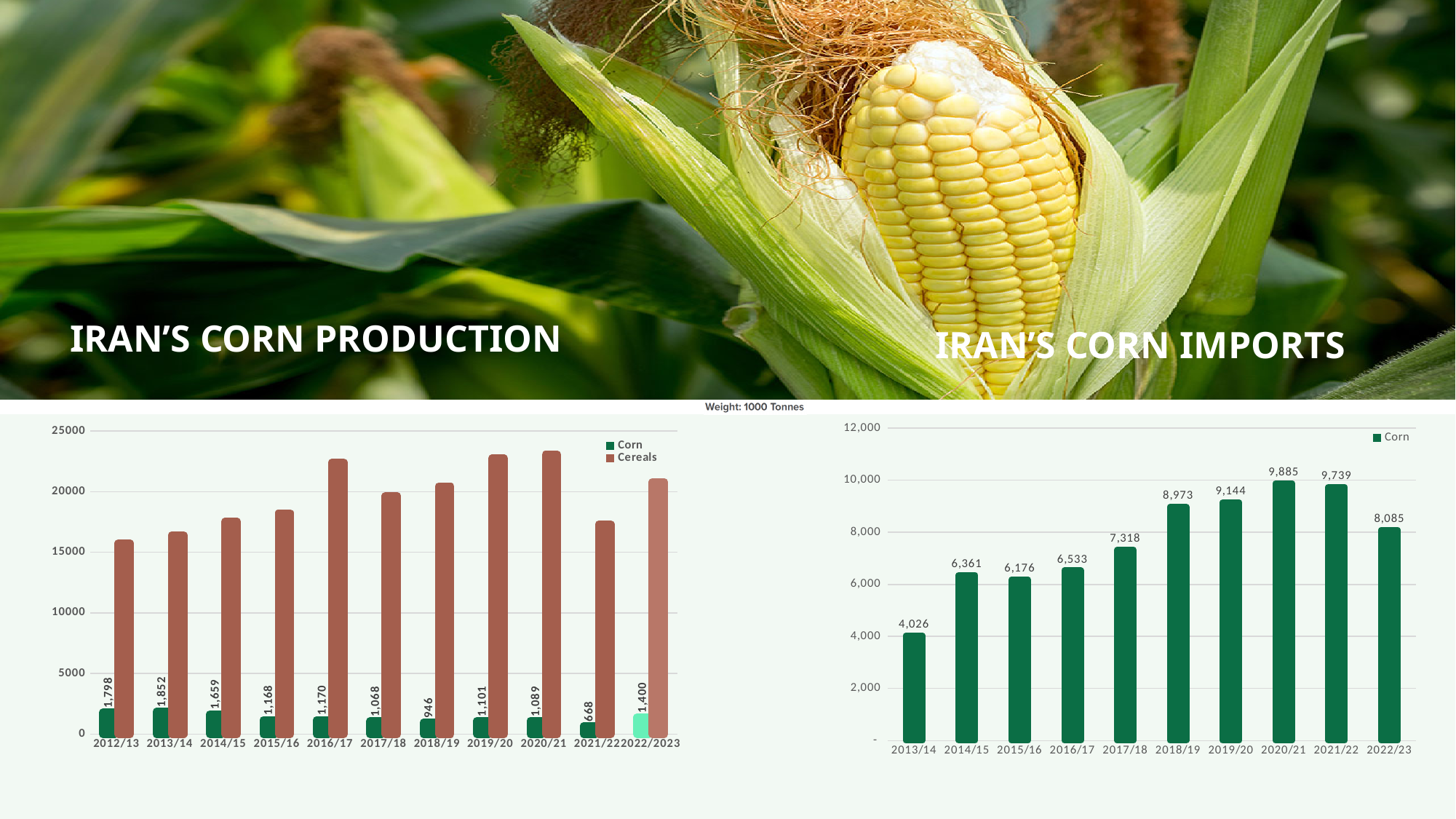
In the IRAN'S CORN PRODUCTION chart, what is the Corn value for 2018/19? 946 In the IRAN'S CORN PRODUCTION chart, which year has the larger Corn value, 2012/13 or 2013/14? 2013/14 In the IRAN'S CORN IMPORTS chart, what is the difference between the 2020/21 value and the 2013/14 value? 5,859 In the IRAN'S CORN PRODUCTION chart, is the Cereals value for 2016/17 greater or less than 20000? greater In the IRAN'S CORN PRODUCTION chart, is the Cereals value for 2021/22 greater or less than 20000? less In the IRAN'S CORN IMPORTS chart, what is the value for 2017/18? 7,318 In the IRAN'S CORN IMPORTS chart, which year has the highest value? 2020/21 How many series does the legend of the IRAN'S CORN PRODUCTION chart list? 2 How many years are shown on the x axis of the IRAN'S CORN IMPORTS chart? 10 In the IRAN'S CORN PRODUCTION chart, which year has the lowest Corn value? 2021/22 What kind of chart is the IRAN'S CORN IMPORTS chart? Bar chart What are the legend entries in the IRAN'S CORN PRODUCTION chart? Corn, Cereals